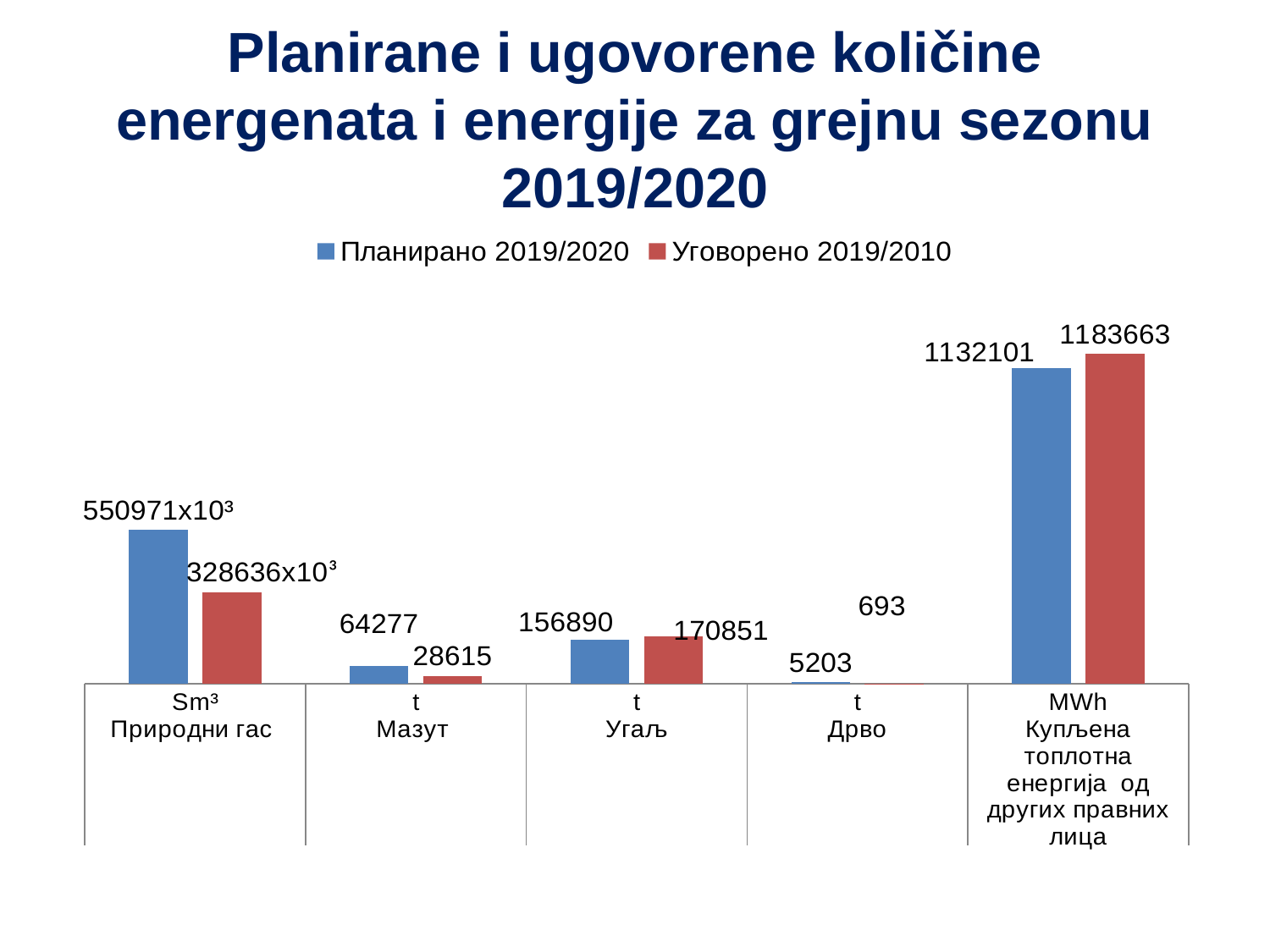
What is the difference between the Планирано 2019/2020 and Уговорено 2019/2010 values for Мазут? 35662 What is the Уговорено 2019/2010 value for Дрво? 693 How many categories are shown on the x axis? 5 What is the Планирано 2019/2020 value for Природни гас? 550971x10³ What is the Уговорено 2019/2010 value for Угаљ? 170851 What is the Планирано 2019/2020 value for Купљена топлотна енергија од других правних лица? 1132101 For Дрво, which is larger: the Планирано 2019/2020 value or the Уговорено 2019/2010 value? Планирано 2019/2020 How many series does the legend list? 2 Which category has the lowest Планирано 2019/2020 value? Дрво Which category has the highest Уговорено 2019/2010 value? Купљена топлотна енергија од других правних лица What is the difference between the Уговорено 2019/2010 and Планирано 2019/2020 values for Угаљ? 13961 What is the Планирано 2019/2020 value for Мазут? 64277